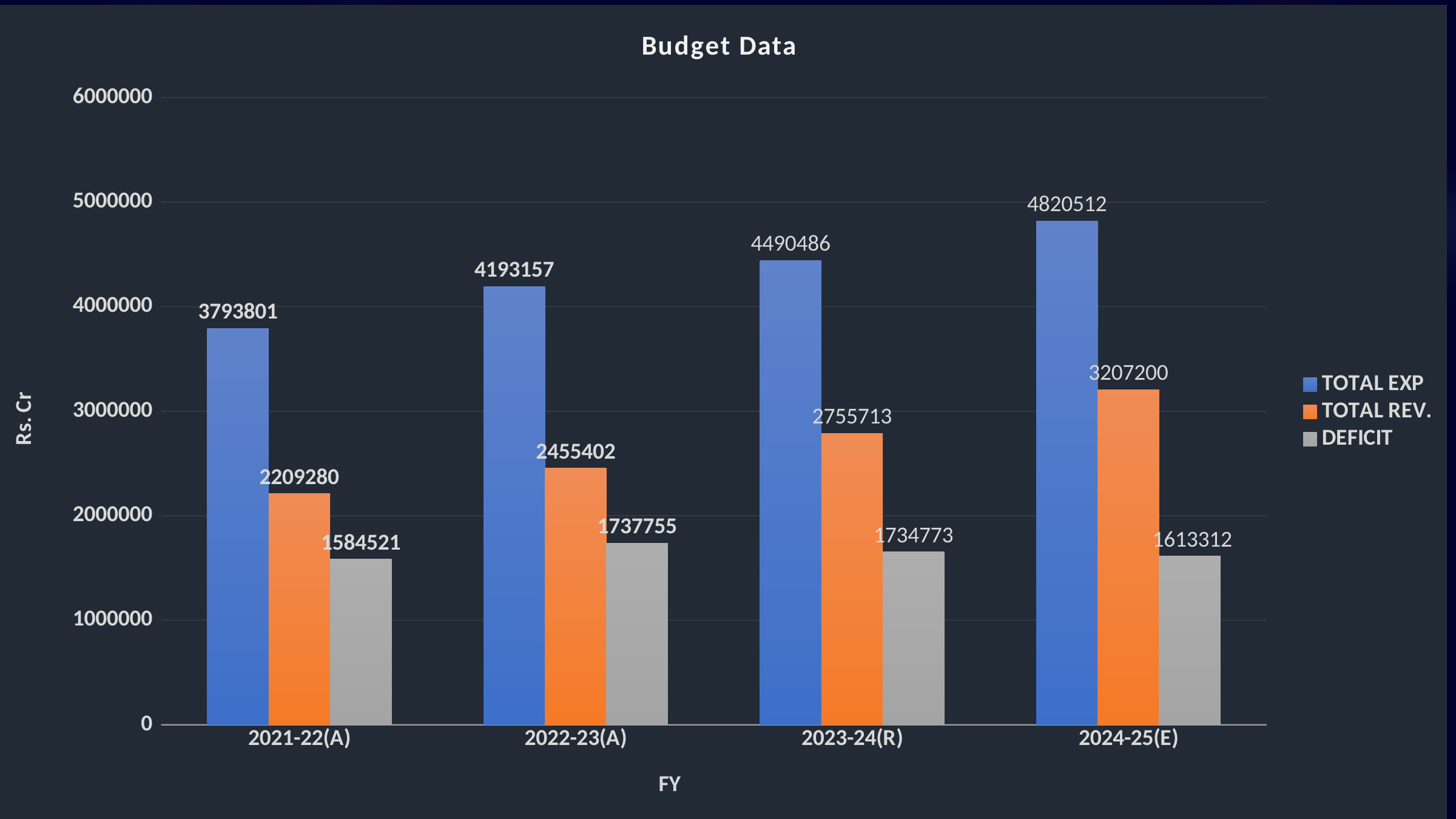
What is the difference between TOTAL EXP and TOTAL REV. for 2022-23(A)? 1737755 Does TOTAL EXP rise or fall from 2021-22(A) to 2024-25(E)? rise Is the TOTAL EXP value for 2021-22(A) greater or less than 4000000? less Which is larger: TOTAL REV. for 2023-24(R) or TOTAL REV. for 2024-25(E)? TOTAL REV. for 2024-25(E) What is the TOTAL EXP value for 2024-25(E)? 4820512 How many series does the legend list? 3 Which fiscal year has the lowest TOTAL REV.? 2021-22(A) How many fiscal years are shown on the x axis? 4 What kind of chart is shown on the slide? bar chart Which fiscal year has the highest TOTAL EXP? 2024-25(E) What is the TOTAL REV. value for 2021-22(A)? 2209280 What is the DEFICIT value for 2023-24(R)? 1734773